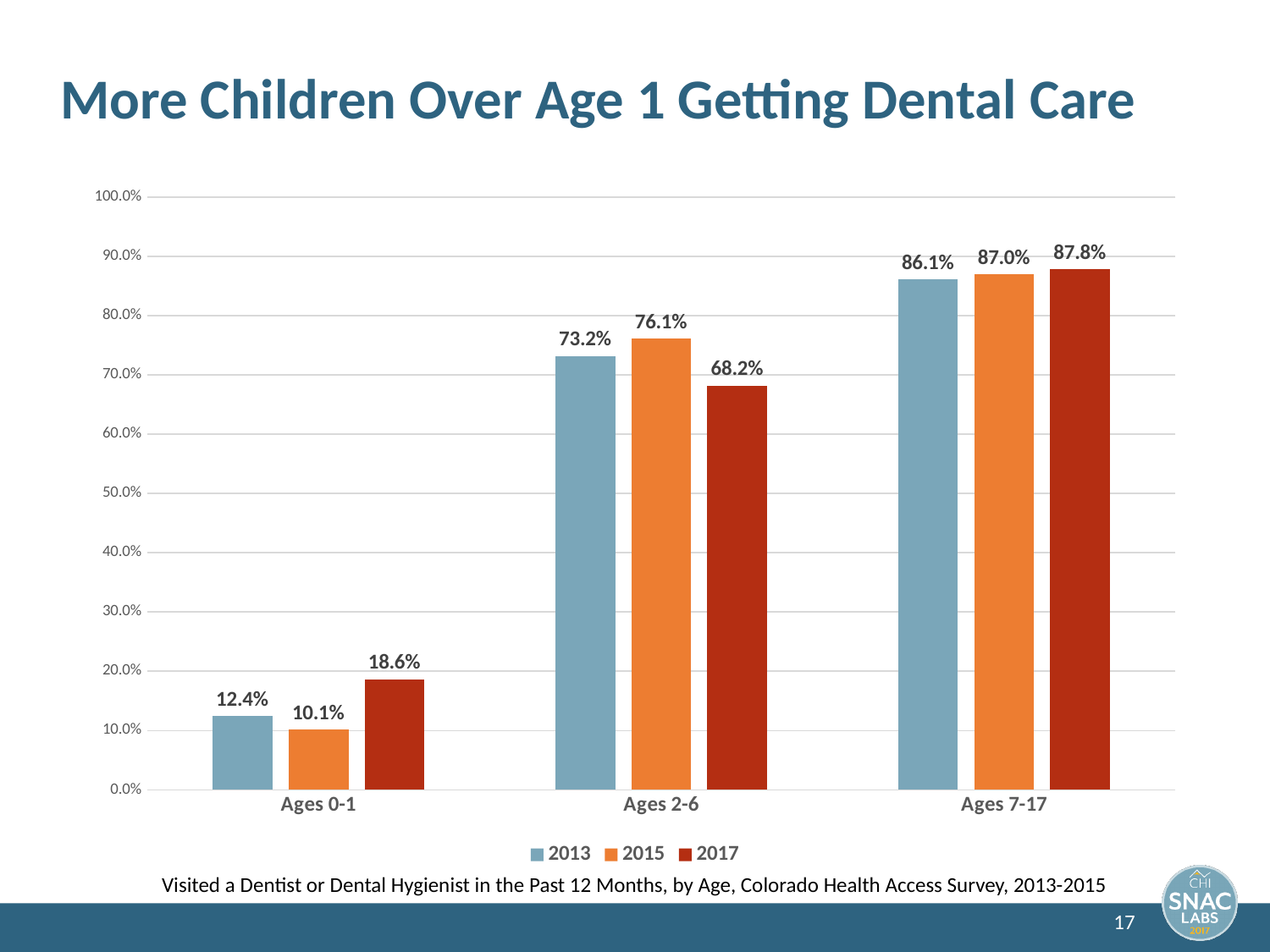
How many series does the legend list? 3 Which is larger for Ages 2-6: the 2015 value or the 2017 value? 2015 Which year is shown in the darkest red bars according to the legend? 2017 Which age group has the lowest value in 2015? Ages 0-1 What is the value for Ages 2-6 in 2017? 68.2% What is the difference between the 2017 and 2013 values for Ages 0-1? 6.2% Which age group has the highest value in 2017? Ages 7-17 What is the value for Ages 0-1 in 2013? 12.4% What is the value for Ages 7-17 in 2015? 87.0% Is the value for Ages 2-6 in 2013 greater or less than 70.0%? greater What kind of chart is shown on the slide? Bar chart How many age groups are shown on the x axis? 3